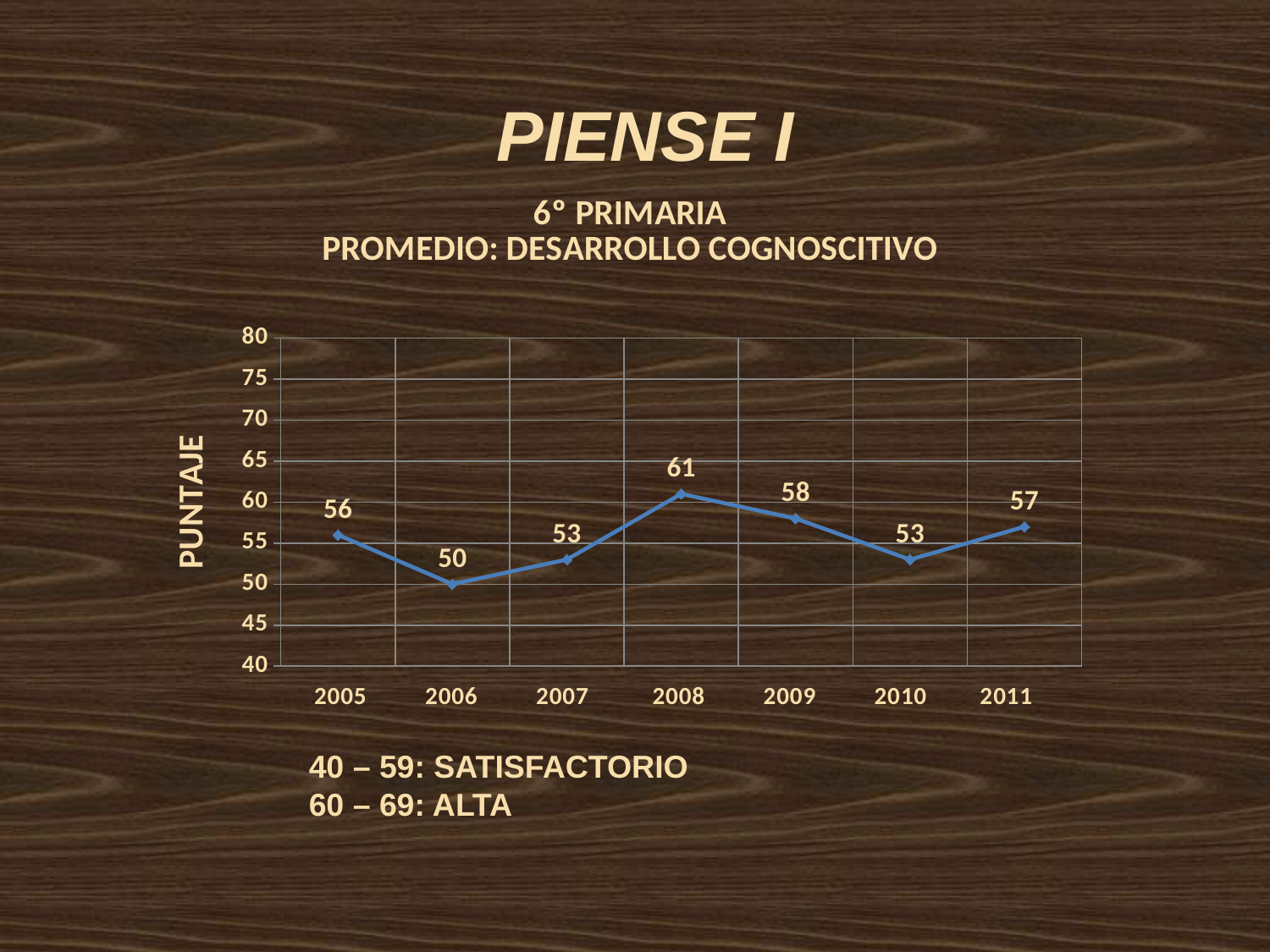
Does the PUNTAJE rise or fall from 2009 to 2010? Fall What is the PUNTAJE value for 2006? 50 What is the PUNTAJE value for 2008? 61 What is the label of the vertical axis? PUNTAJE Which year has the highest PUNTAJE? 2008 Is the value for 2008 greater or less than 60? greater Which year has a higher PUNTAJE, 2005 or 2009? 2009 Which year has the lowest PUNTAJE? 2006 What is the PUNTAJE value for 2011? 57 What kind of chart is shown on the slide? Line chart What is the difference between the PUNTAJE values for 2008 and 2006? 11 How many years are plotted on the x axis? 7